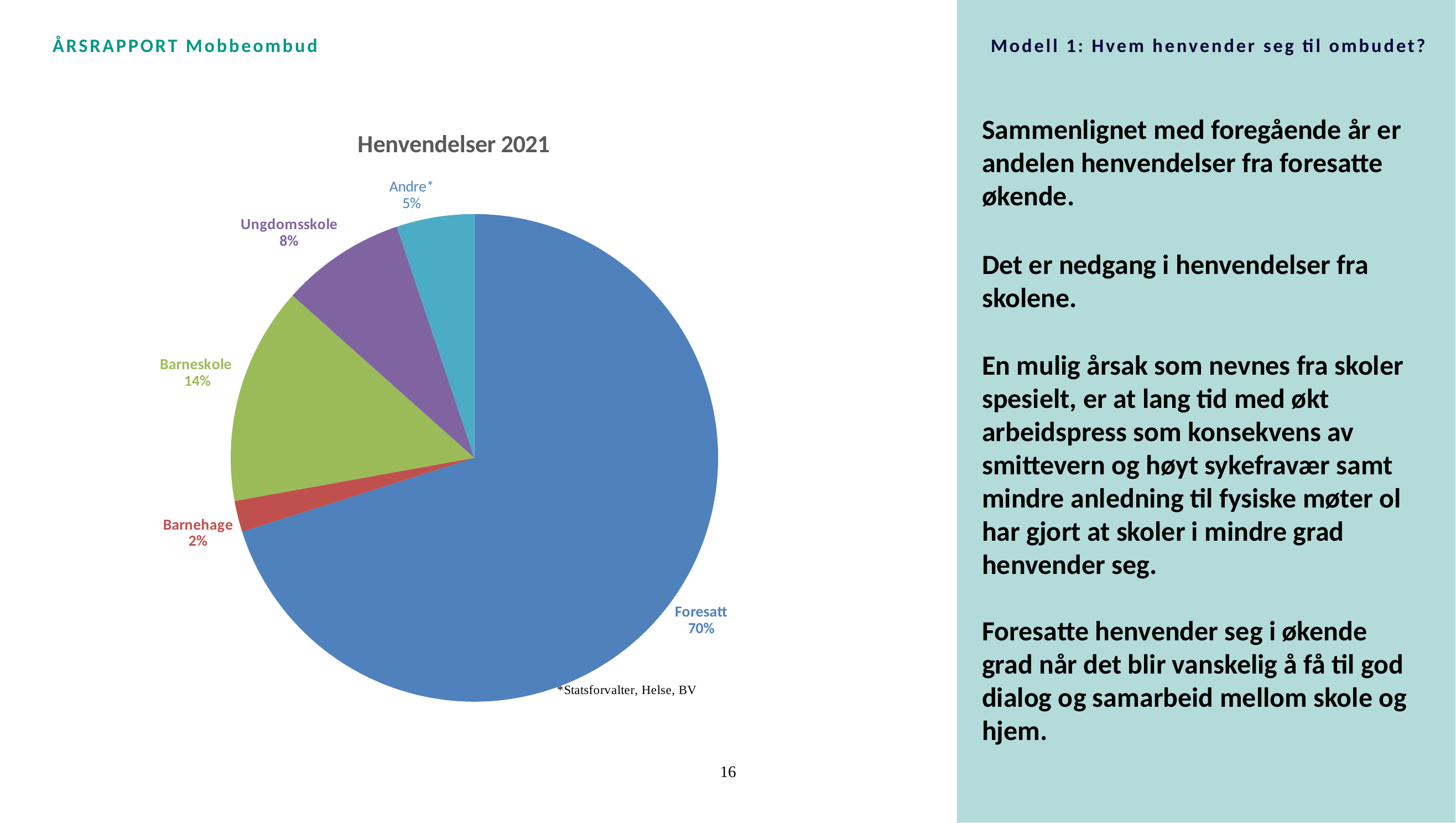
What share of the pie does Barneskole represent? 14% What is the title of the chart? Henvendelser 2021 What share of the pie does Andre* represent? 5% How many categories are shown in the pie chart? 5 Which is larger, the share for Ungdomsskole or the share for Andre*? Ungdomsskole Which category has the largest slice of the pie? Foresatt What share of the pie does Ungdomsskole represent? 8% What kind of chart is shown on the slide? Pie chart What is the difference in percentage points between Barneskole and Ungdomsskole? 6 Which category has the smallest slice of the pie? Barnehage